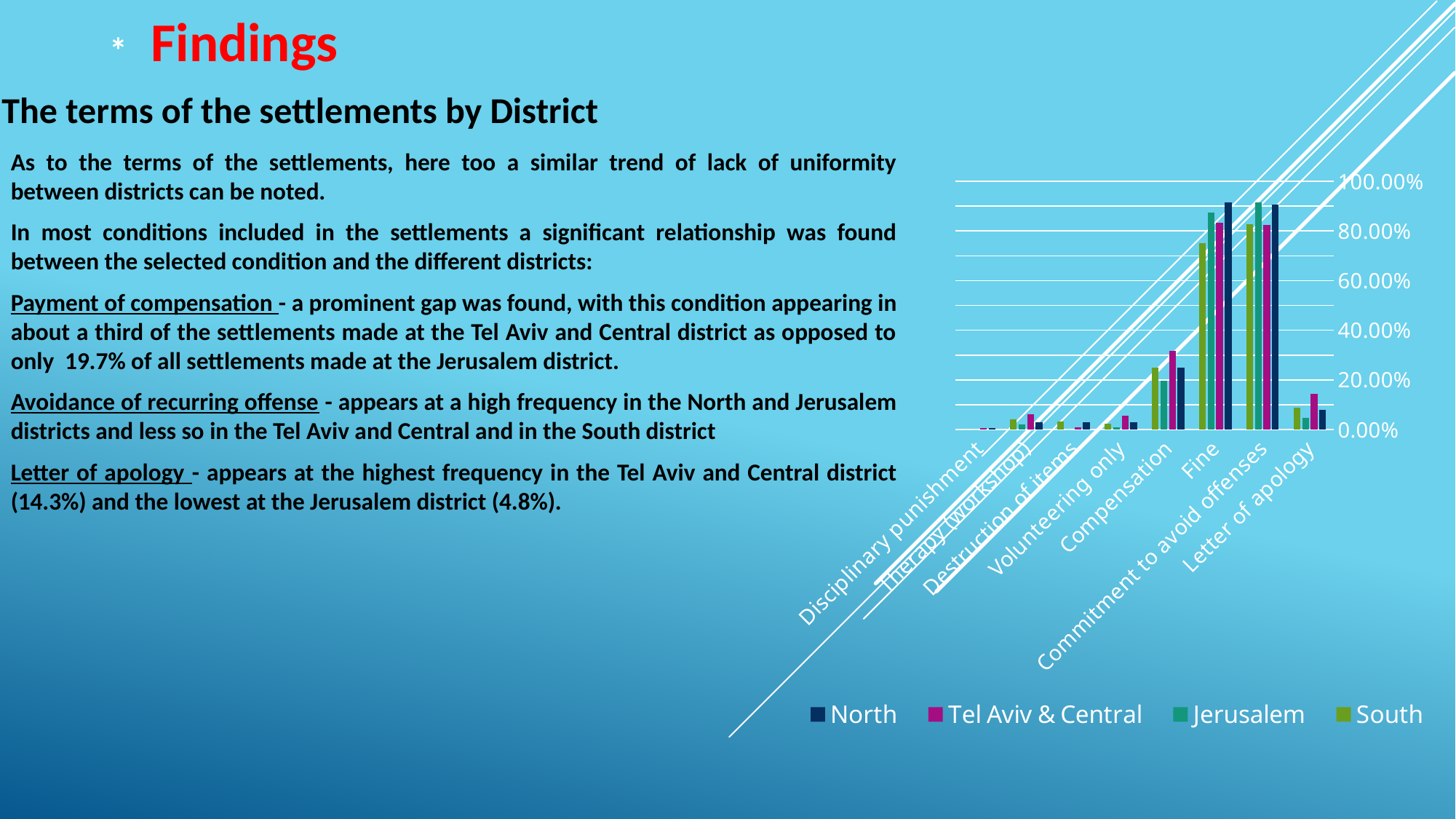
Is the value for Tel Aviv & Central in the Compensation category greater or less than 20.00%? greater How many categories are shown on the x axis of the chart? 8 What kind of chart is shown on the slide? Bar chart Which series are listed in the chart legend? North, Tel Aviv & Central, Jerusalem, South Is the value for Jerusalem in the Letter of apology category greater or less than 20.00%? less How many series does the chart legend list? 4 Which is larger for North: the value for Fine or the value for Volunteering only? Fine Is the value for North in the Fine category greater or less than 80.00%? greater Which is larger for Tel Aviv & Central: the value for Compensation or the value for Letter of apology? Compensation